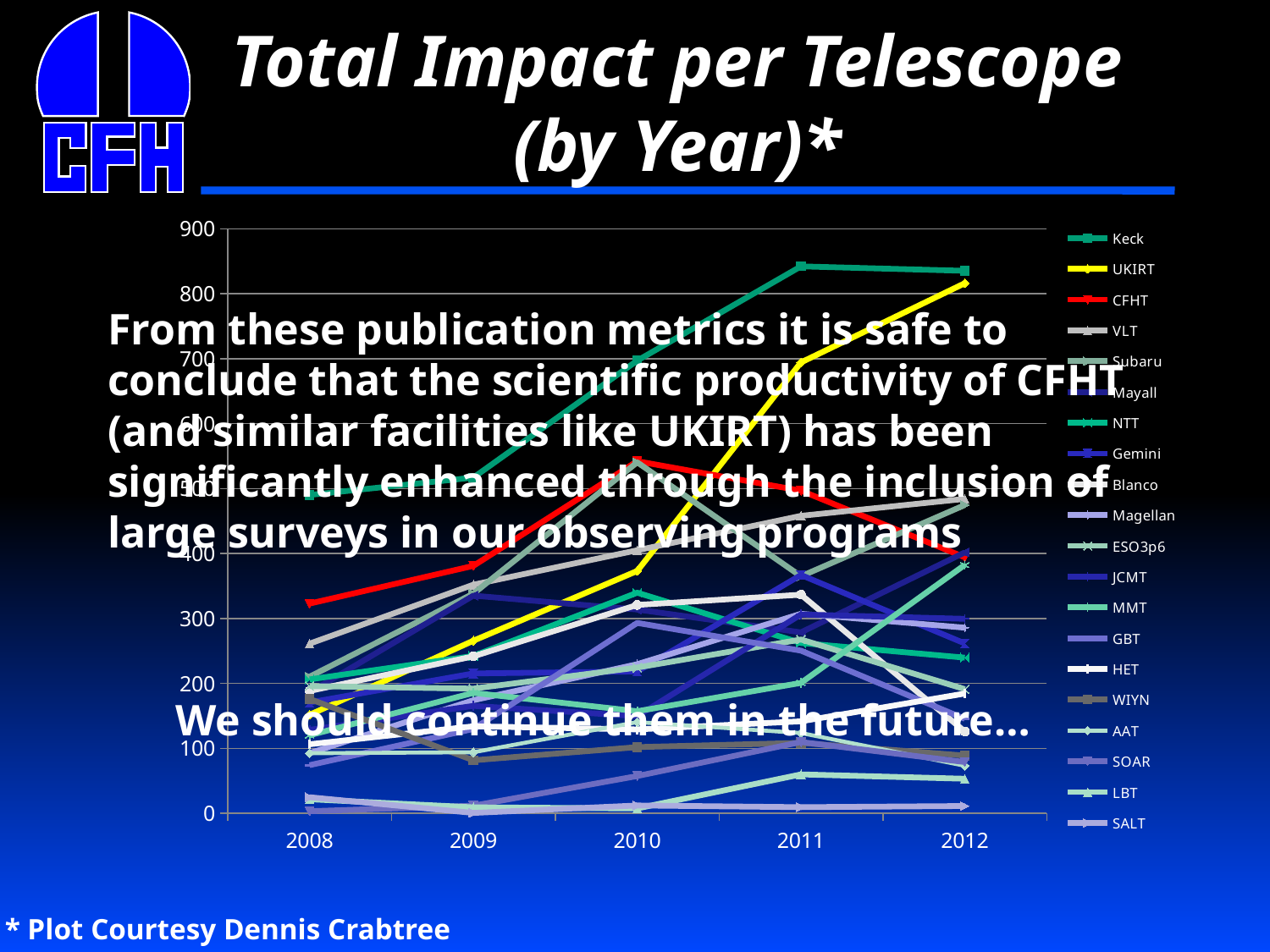
How many series does the chart's legend list? 20 Which is larger in 2009, the value for CFHT or the value for UKIRT? CFHT What kind of chart is shown on the slide? line chart Which telescope has the highest value in 2011? Keck Which is larger in 2012, the value for UKIRT or the value for CFHT? UKIRT Is the value for UKIRT in 2010 greater or less than 400? less What colour is the UKIRT line in the chart? yellow Is the value for UKIRT in 2008 greater or less than 200? less Does the value for UKIRT rise or fall from 2008 to 2012? rise Is the value for Keck in 2011 greater or less than 800? greater How many years are shown along the x axis of the chart? 5